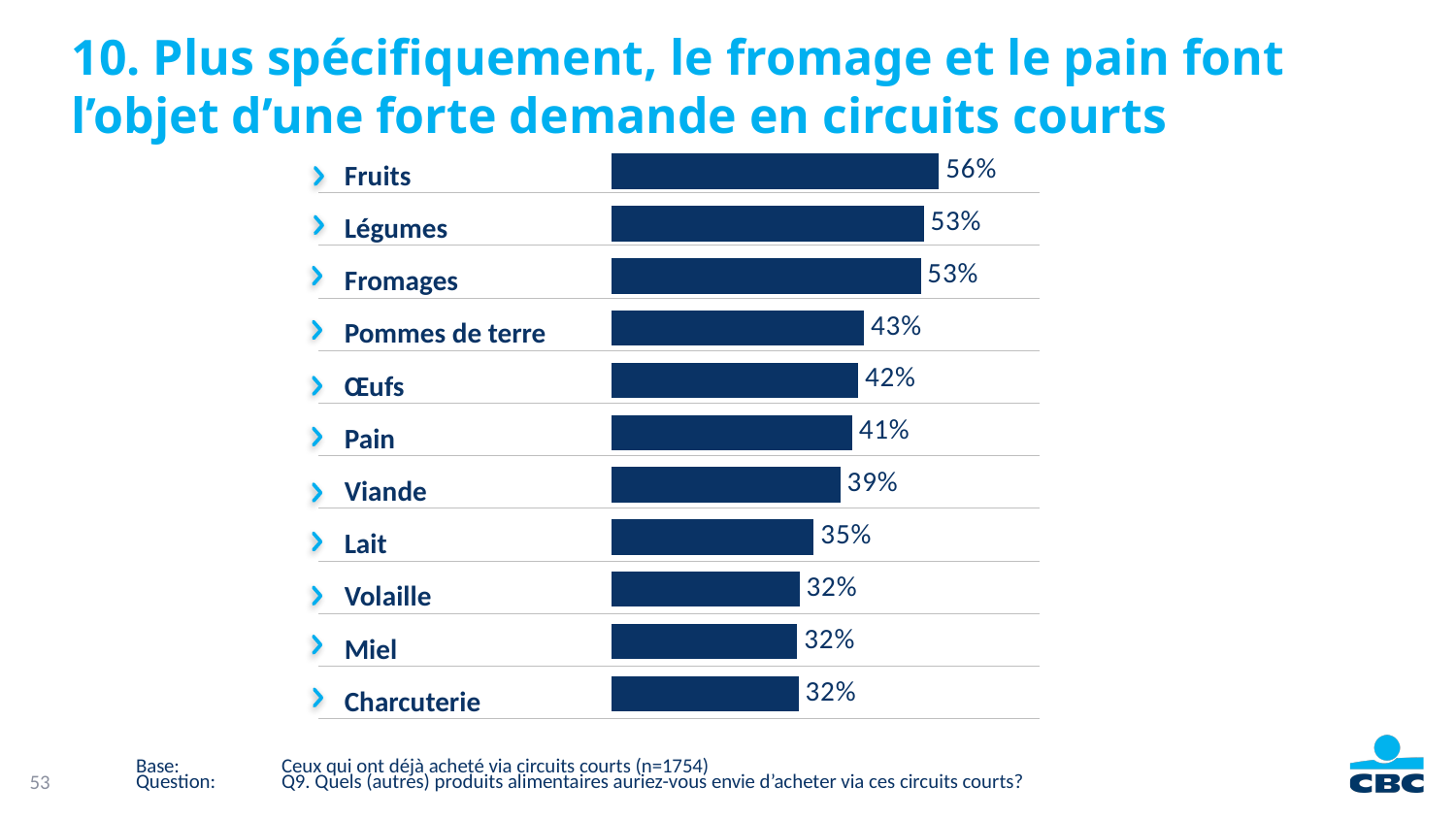
Which is larger, the value for Œufs or the value for Volaille? Œufs Which category has the highest value? Fruits How many categories share the lowest value of 32%? 3 What is the difference between the values for Fromages and Pain? 12% What is the value for Pain? 41% What is the value for Pommes de terre? 43% What is the difference between the values for Fruits and Viande? 17% What is the value for Fruits? 56% How many categories are shown in the chart? 11 What is the value for Lait? 35% What kind of chart is shown on the slide? Bar chart Which is larger, the value for Légumes or the value for Lait? Légumes